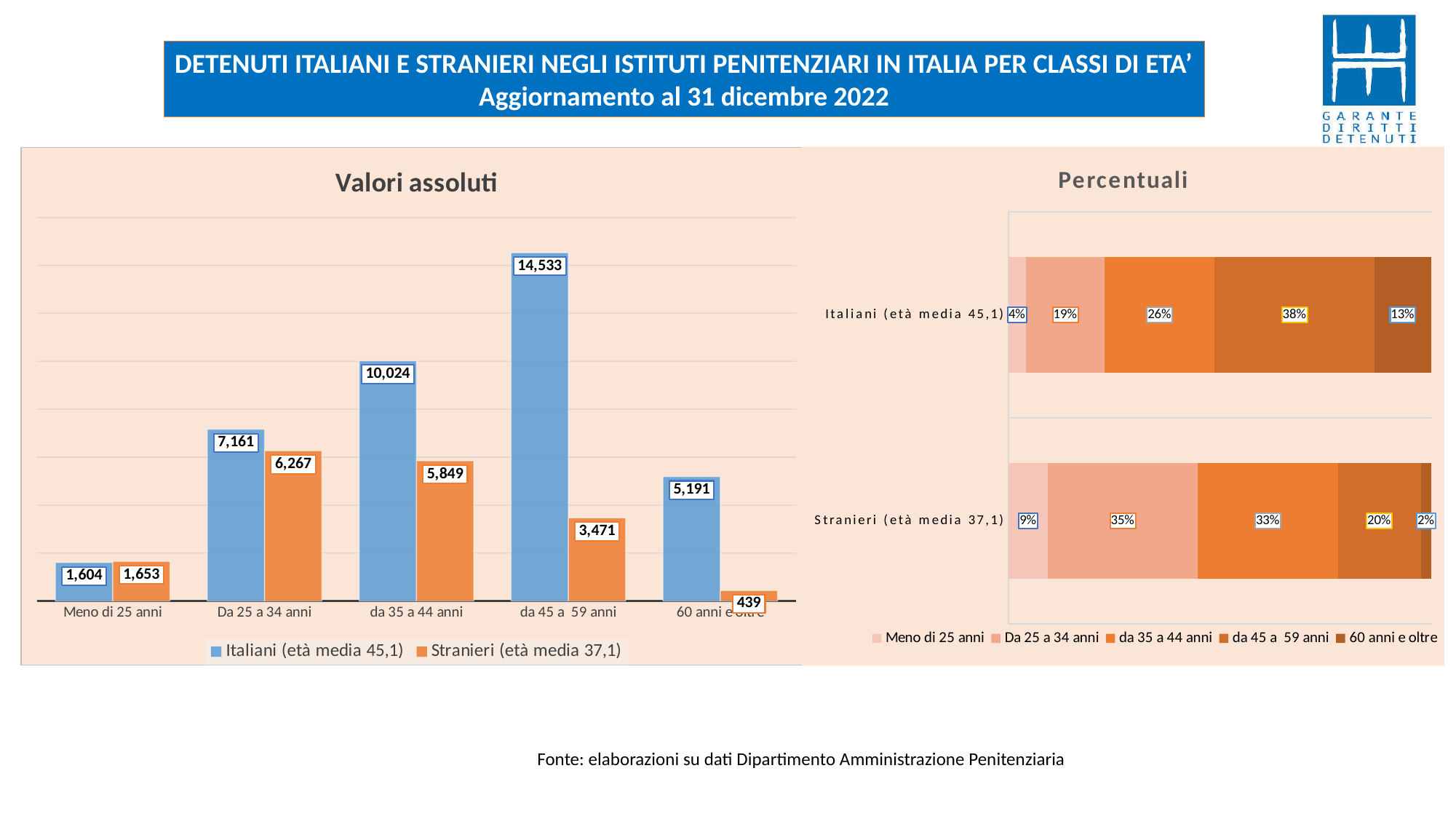
In the 'Valori assoluti' chart, which is larger for 'Meno di 25 anni': Italiani or Stranieri? Stranieri In the 'Valori assoluti' chart, which age class has the lowest value for Stranieri? 60 anni e oltre In the 'Percentuali' chart, how many age classes does the legend list? 5 In the 'Valori assoluti' chart, which age class has the highest value for Italiani? da 45 a 59 anni In the 'Percentuali' chart, what is the share of 'da 45 a 59 anni' for Italiani (età media 45,1)? 38% In the 'Valori assoluti' chart, what is the value for Italiani in the 'da 45 a 59 anni' age class? 14,533 In the 'Valori assoluti' chart, what is the value for Stranieri in the 'Da 25 a 34 anni' age class? 6,267 In the 'Valori assoluti' chart, what is the difference between Italiani and Stranieri in the 'da 35 a 44 anni' age class? 4,175 In the 'Valori assoluti' chart, how many age classes are shown on the x axis? 5 What kind of chart is the 'Percentuali' chart? Stacked bar chart In the 'Valori assoluti' chart, how many series does the legend list? 2 In the 'Percentuali' chart, what is the share of 'Da 25 a 34 anni' for Stranieri (età media 37,1)? 35%